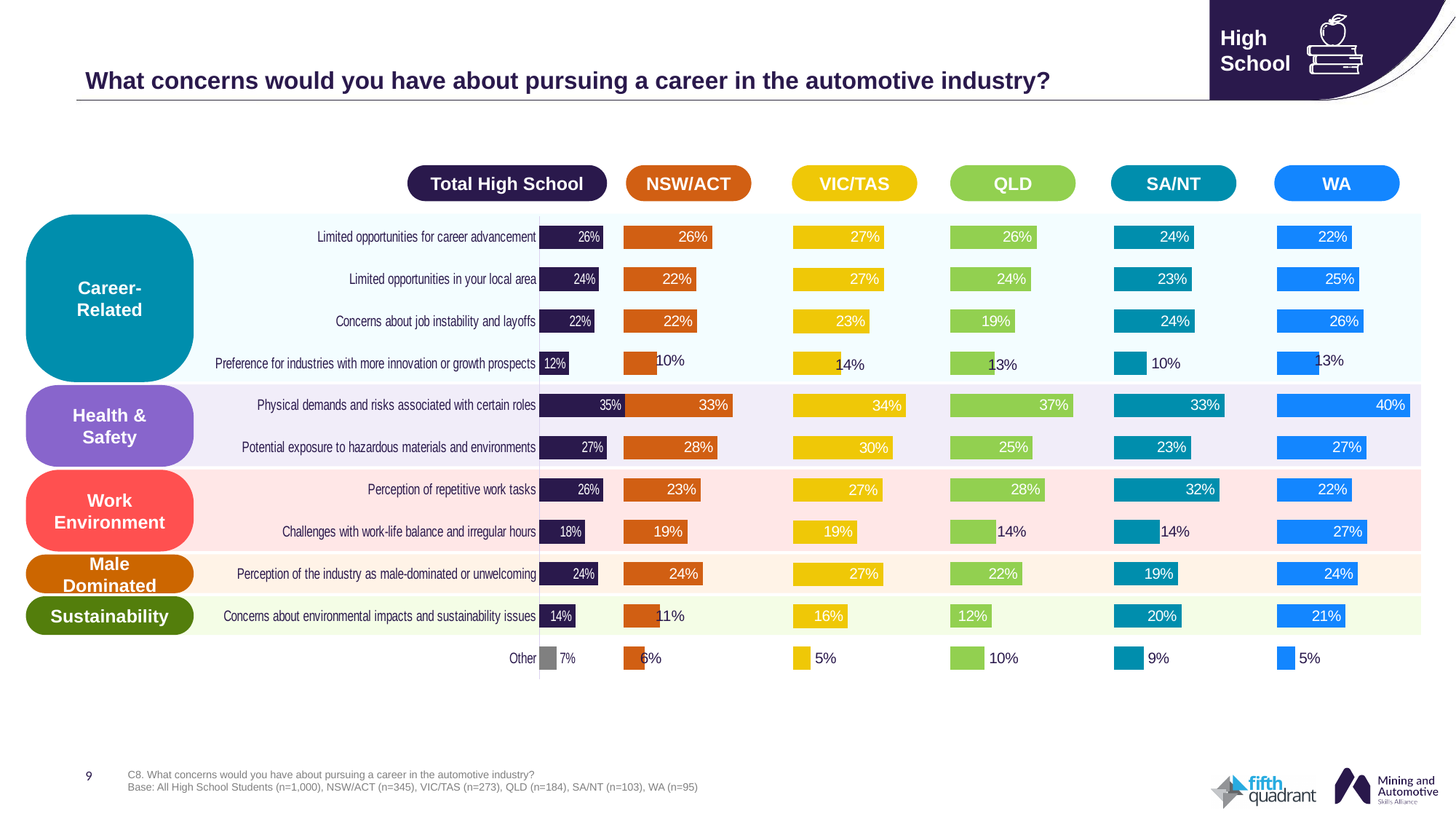
In the VIC/TAS chart, which is larger: Potential exposure to hazardous materials and environments or Perception of repetitive work tasks? Potential exposure to hazardous materials and environments In the Total High School chart, which category has the lowest value? Other How many concern categories are plotted in the Total High School chart? 11 In the NSW/ACT chart, what is the value for Concerns about environmental impacts and sustainability issues? 11% In the WA chart, what is the value for Physical demands and risks associated with certain roles? 40% How many region charts (including Total High School) are shown on the slide? 6 In the WA chart, what is the difference between Physical demands and risks associated with certain roles and Limited opportunities for career advancement? 18 percentage points In the QLD chart, what is the value for Other? 10% In the QLD chart, which concern has the highest value? Physical demands and risks associated with certain roles In the SA/NT chart, what is the difference between Perception of repetitive work tasks and Challenges with work-life balance and irregular hours? 18 percentage points In the SA/NT chart, what is the value for Concerns about job instability and layoffs? 24% What kind of chart is used to show the NSW/ACT results? Bar chart